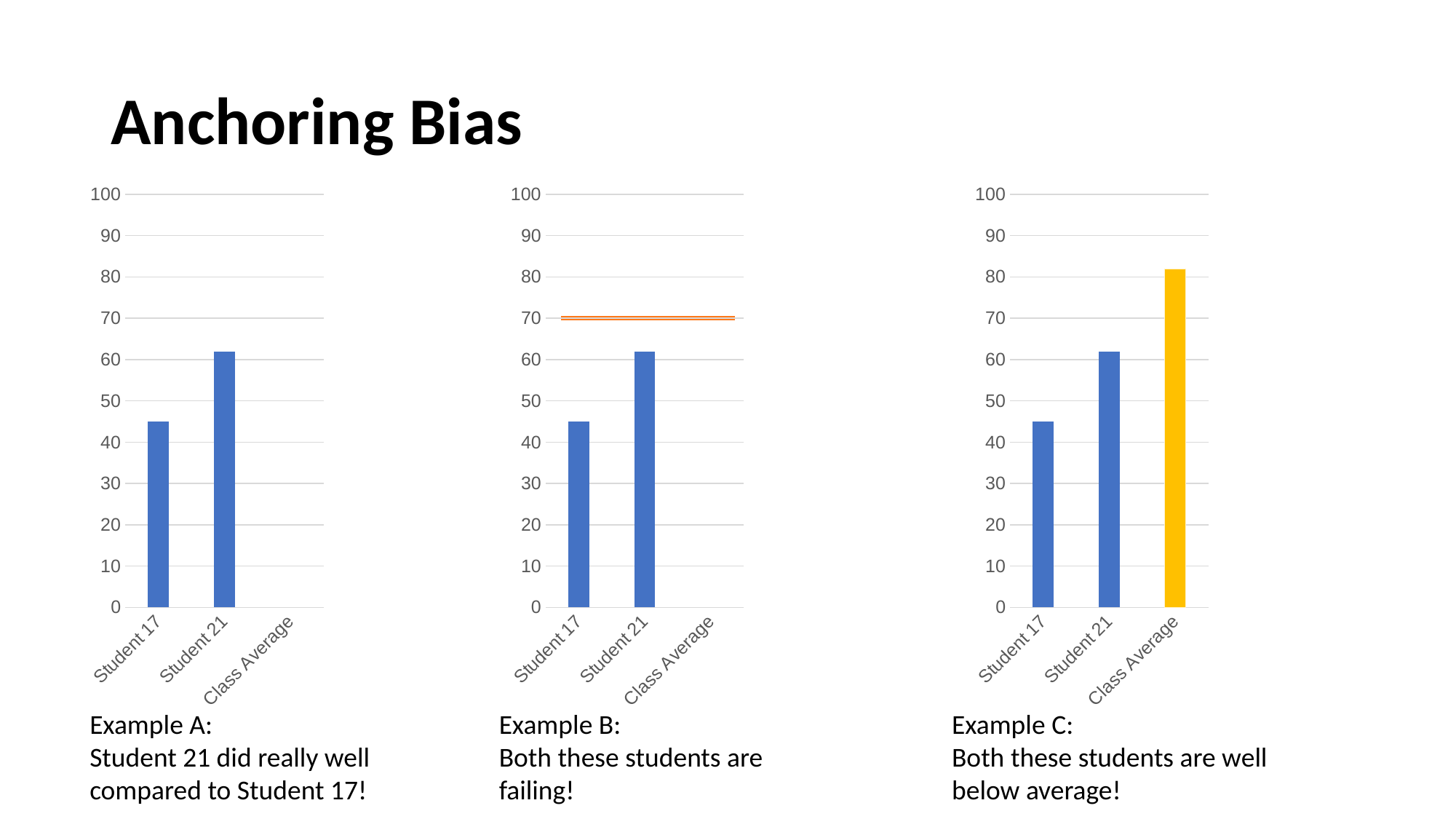
In the left chart (Example A), which student has the higher bar, Student 17 or Student 21? Student 21 In the left chart (Example A), is the value for Student 21 greater or less than 60? greater In the right chart (Example C), which category has the lowest bar? Student 17 In the middle chart (Example B), is the value for Student 21 greater or less than 70? less In the middle chart (Example B), is the value for Student 17 greater or less than 40? greater In the middle chart (Example B), at what value on the y axis is the orange horizontal line drawn? 70 In the right chart (Example C), what colour is the Class Average bar? yellow In the right chart (Example C), which category has the highest bar? Class Average In the right chart (Example C), how many bars are plotted? 3 In the left chart (Example A), what kind of chart is shown? bar chart